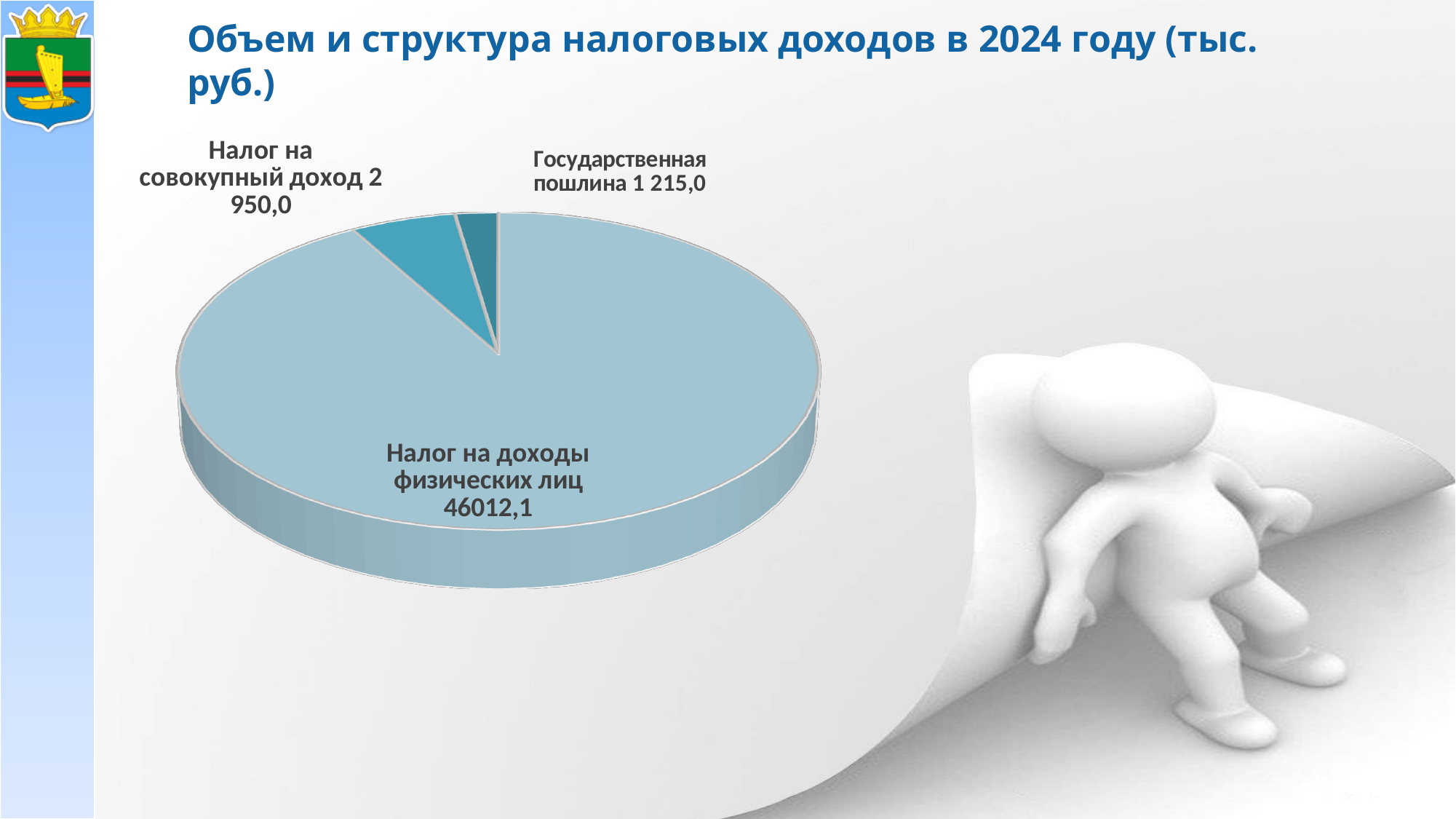
What type of chart is shown on the slide? Pie chart Which is larger, Налог на совокупный доход or Государственная пошлина? Налог на совокупный доход What is the difference between Налог на совокупный доход and Государственная пошлина? 1 735,0 What is the difference between Налог на доходы физических лиц and Налог на совокупный доход? 43062,1 What is the total of all three slices in the pie chart? 50177,1 Which category has the largest slice of the pie? Налог на доходы физических лиц Which category has the smallest slice of the pie? Государственная пошлина How many categories are shown in the pie chart? 3 What is the value for Налог на доходы физических лиц? 46012,1 What is the value for Государственная пошлина? 1 215,0 What is the title of the chart on the slide? Объем и структура налоговых доходов в 2024 году (тыс. руб.) What is the value for Налог на совокупный доход? 2 950,0